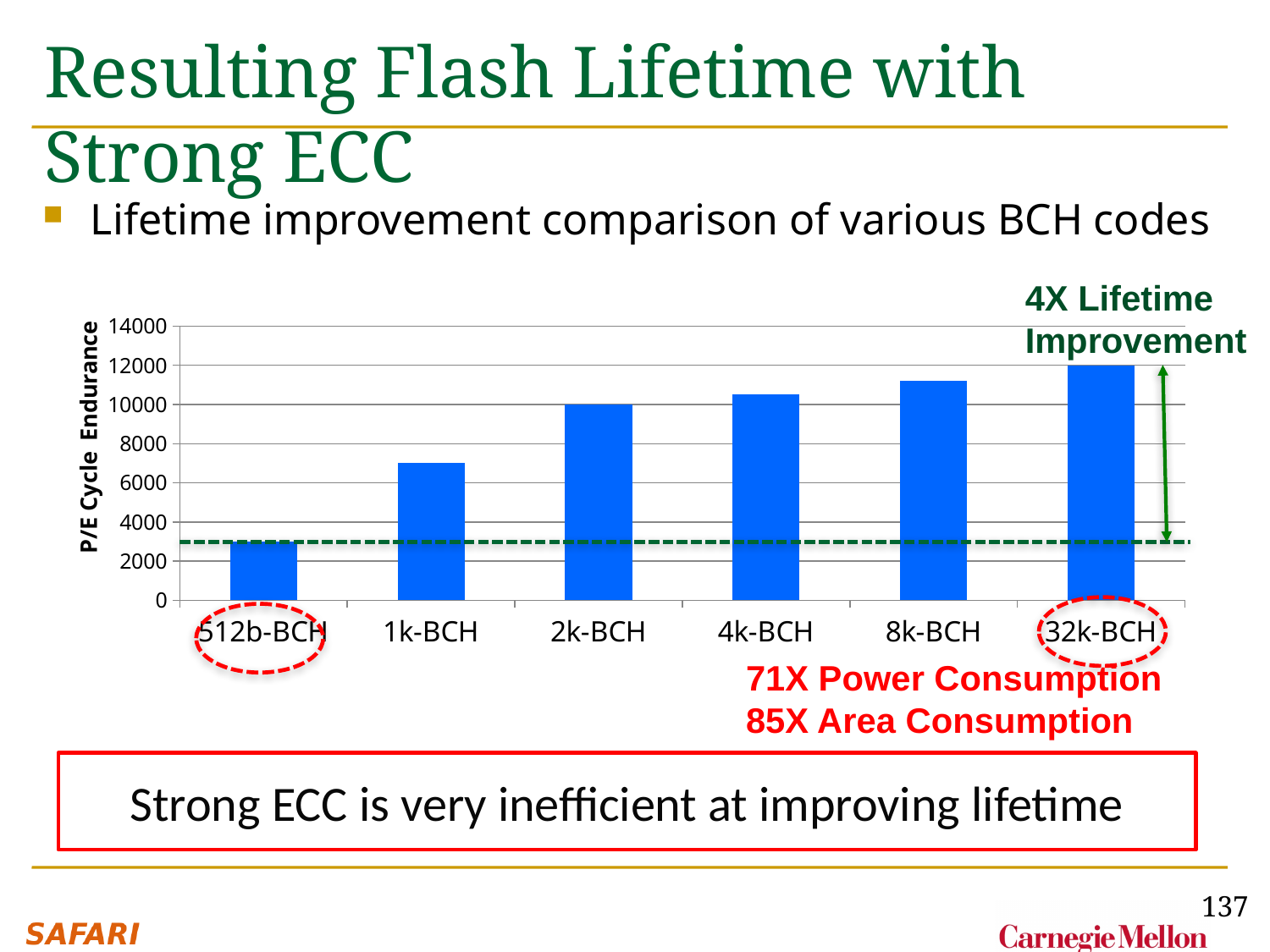
How many BCH code categories are plotted on the x axis? 6 Is the P/E cycle endurance for 512b-BCH greater or less than 4000? less Do the P/E cycle endurance values rise or fall from 512b-BCH to 32k-BCH? rise Which BCH code has the highest P/E cycle endurance? 32k-BCH Is the P/E cycle endurance for 1k-BCH greater or less than 6000? greater Is the P/E cycle endurance for 8k-BCH greater or less than 10000? greater What is the P/E cycle endurance for 32k-BCH? 12000 Which has a higher P/E cycle endurance, 1k-BCH or 2k-BCH? 2k-BCH What is the label on the y axis of the chart? P/E Cycle Endurance What kind of chart is shown on the slide? bar chart Which BCH code has the lowest P/E cycle endurance? 512b-BCH What lifetime improvement does the green annotation on the chart state? 4X Lifetime Improvement